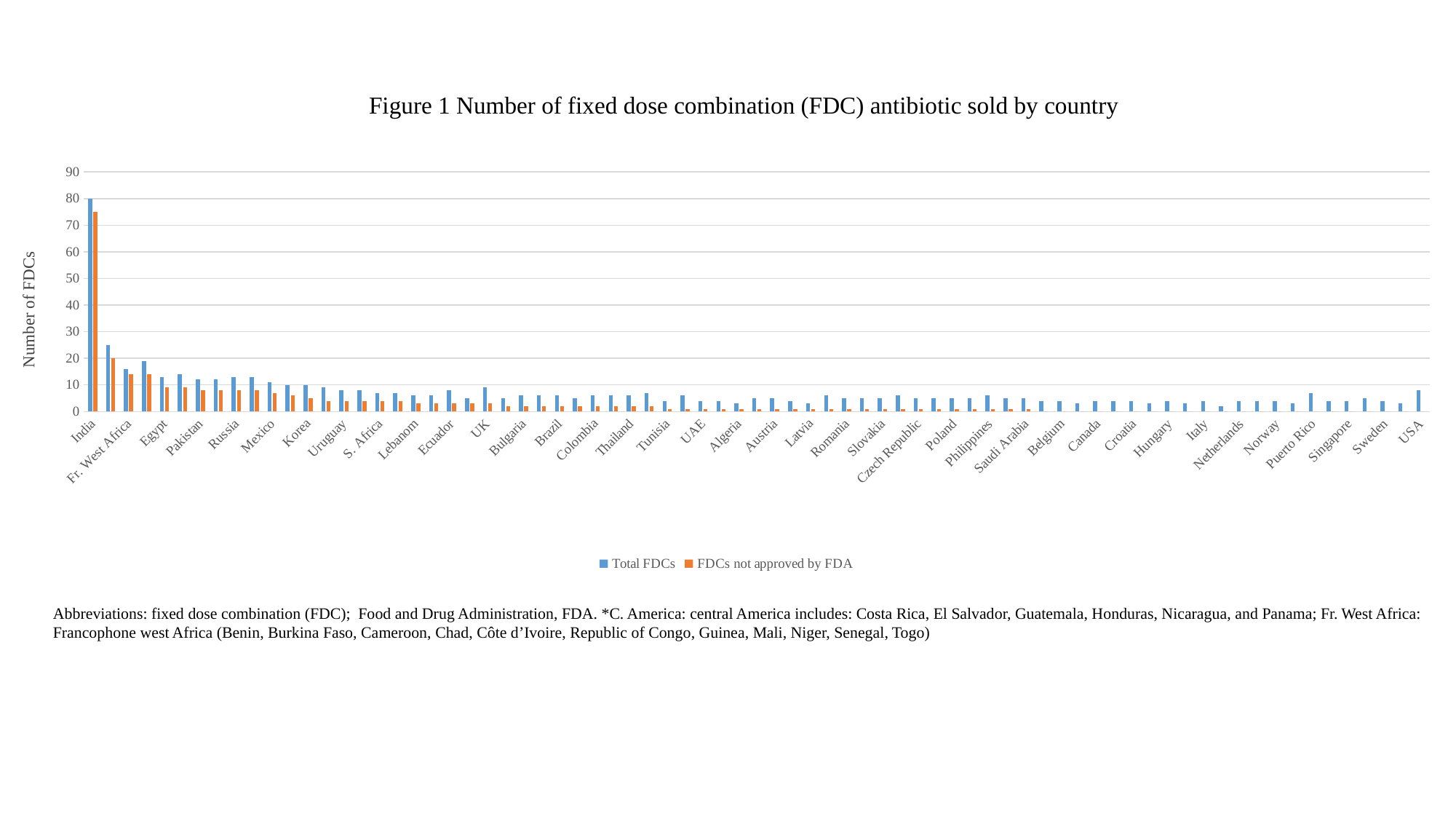
Is the Total FDCs value for Fr. West Africa greater or less than 20? less Which country has the larger Total FDCs value, India or Fr. West Africa? India What is the label on the vertical axis of the chart? Number of FDCs Which is larger for India: Total FDCs or FDCs not approved by FDA? Total FDCs Which country has the highest value for FDCs not approved by FDA? India How many series does the legend list? 2 Is the Total FDCs value for India greater or less than 70? greater Is the Total FDCs value for USA greater or less than 10? less Do the Total FDCs values generally rise or fall moving from left to right along the x axis? fall What kind of chart is shown on the slide? bar chart Which country has the highest value for Total FDCs? India